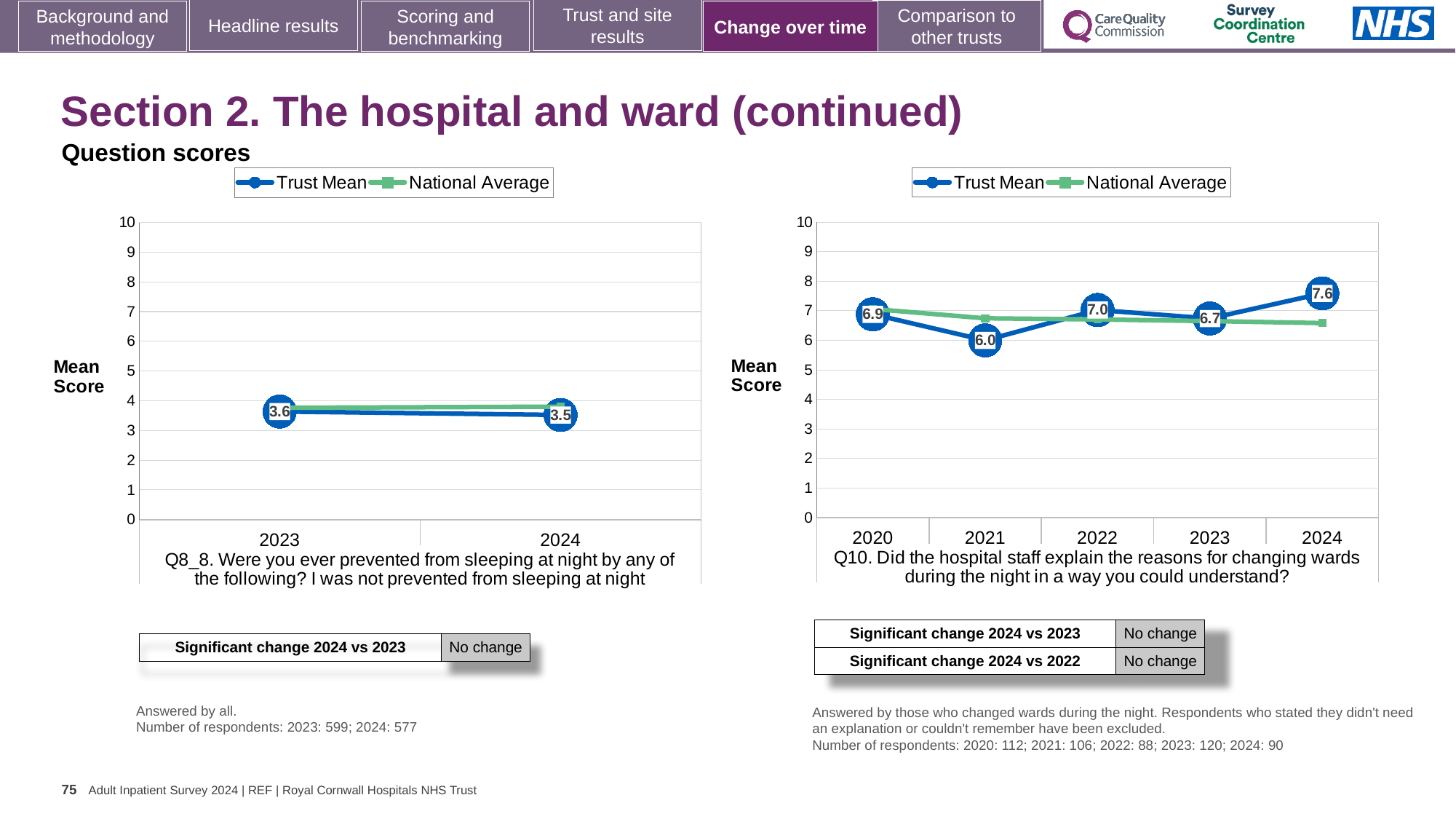
In the Q8_8 chart on the left, what is the Trust Mean score for 2023? 3.6 In the Q10 chart on the right, what is the Trust Mean score for 2024? 7.6 In the Q10 chart on the right, what is the Trust Mean score for 2021? 6.0 What type of chart is the Q10 chart on the right? Line chart In the Q10 chart on the right, which year has the highest Trust Mean score? 2024 In the Q10 chart on the right, what is the difference between the Trust Mean scores for 2024 and 2023? 0.9 In the Q10 chart on the right, how many years are plotted on the x axis? 5 In the Q8_8 chart on the left, what is the Trust Mean score for 2024? 3.5 In the Q10 chart on the right, which year has the lowest Trust Mean score? 2021 In the Q8_8 chart on the left, how many years are shown on the x axis? 2 In the Q10 chart on the right, is the Trust Mean score for 2020 or 2022 larger? 2022 In the Q8_8 chart on the left, how many series does the legend list? 2